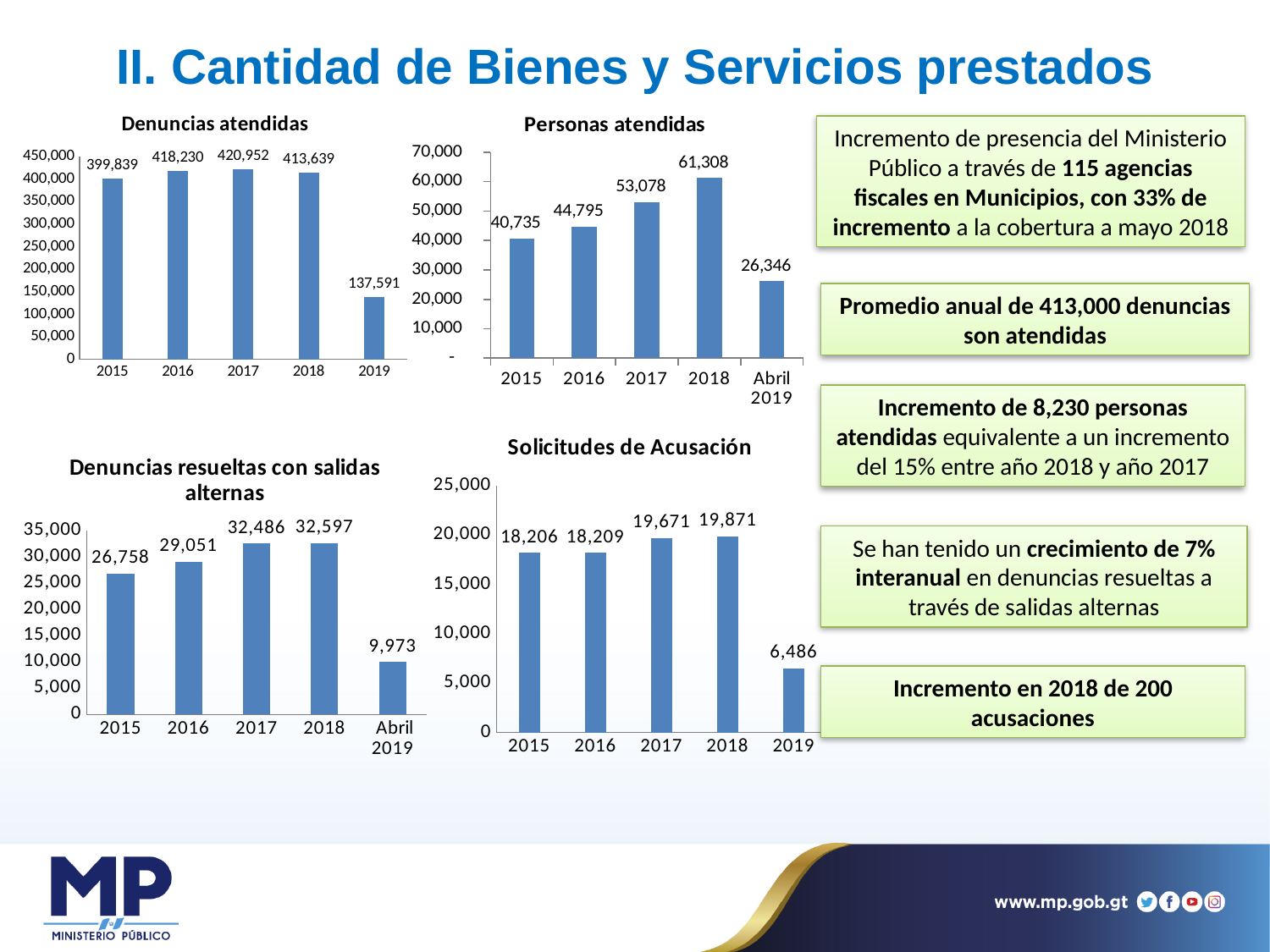
In the 'Personas atendidas' chart, do the values rise or fall from 2015 to 2018? rise In the 'Solicitudes de Acusación' chart, is the value for 2019 greater or less than 10,000? less In the 'Personas atendidas' chart, what is the value for 2018? 61,308 How many bars are in the 'Denuncias atendidas' chart? 5 In the 'Personas atendidas' chart, what is the difference between the 2018 and 2017 values? 8,230 In the 'Denuncias resueltas con salidas alternas' chart, what is the value for Abril 2019? 9,973 In the 'Denuncias atendidas' chart, what is the value for 2017? 420,952 In the 'Solicitudes de Acusación' chart, what is the difference between the 2018 and 2017 values? 200 In the 'Denuncias resueltas con salidas alternas' chart, which year has the highest value? 2018 What type of chart is 'Personas atendidas'? bar chart In the 'Denuncias atendidas' chart, which year has the lowest value? 2019 In the 'Solicitudes de Acusación' chart, what is the value for 2016? 18,209